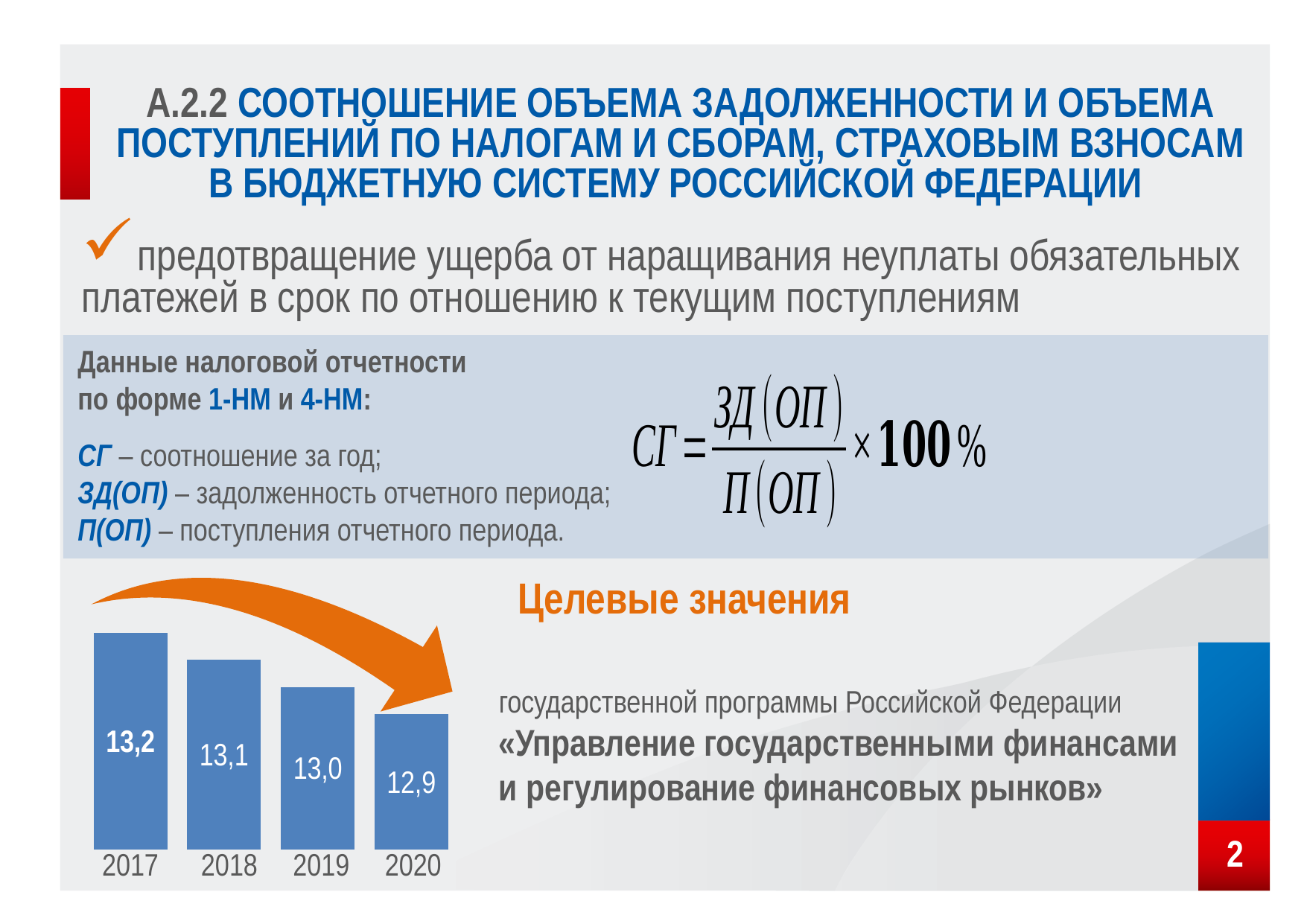
What is the difference between the values for 2017 and 2020? 0,3 What is the value for 2017? 13,2 Which year has the lowest value? 2020 Which is larger, the value for 2018 or the value for 2019? 2018 Do the values rise or fall from 2017 to 2020? fall What colour are the bars in the chart? blue Which year has the highest value? 2017 What kind of chart is shown on the slide? bar chart How many years are shown in the chart? 4 What is the value for 2020? 12,9 What is the value for 2019? 13,0 What is the value for 2018? 13,1